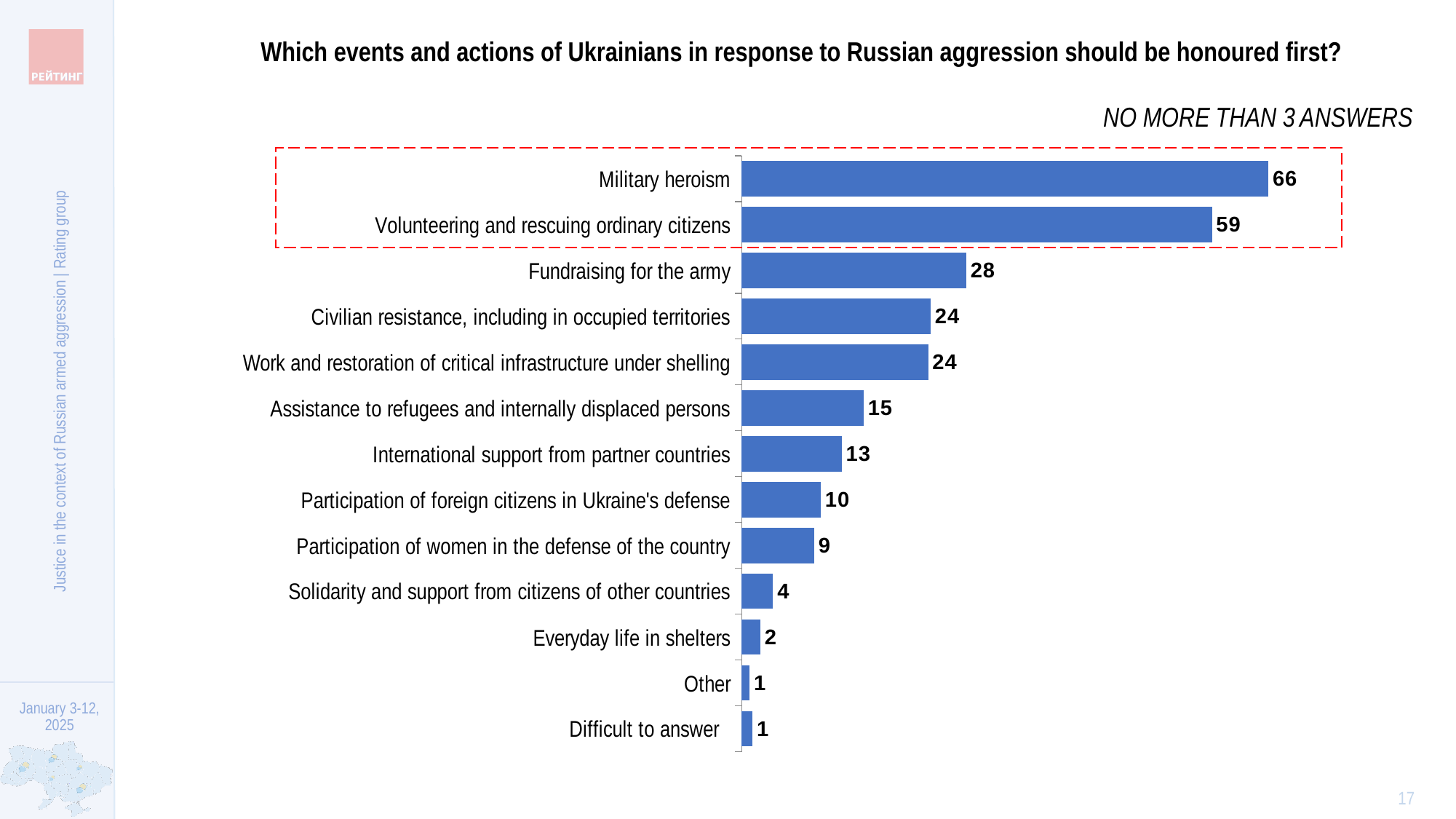
Which is larger: the value for International support from partner countries or the value for Participation of foreign citizens in Ukraine's defense? International support from partner countries How many categories are shown in the chart? 13 What is the value for Everyday life in shelters? 2 What is the difference between the values for Military heroism and Volunteering and rescuing ordinary citizens? 7 What is the difference between the values for Fundraising for the army and Civilian resistance, including in occupied territories? 4 What is the value for Participation of women in the defense of the country? 9 What is the value for Military heroism? 66 What kind of chart is shown on the slide? Bar chart What is the value for Fundraising for the army? 28 What is the value for Assistance to refugees and internally displaced persons? 15 Which category has the highest value? Military heroism How many categories are enclosed by the red dashed box? 2